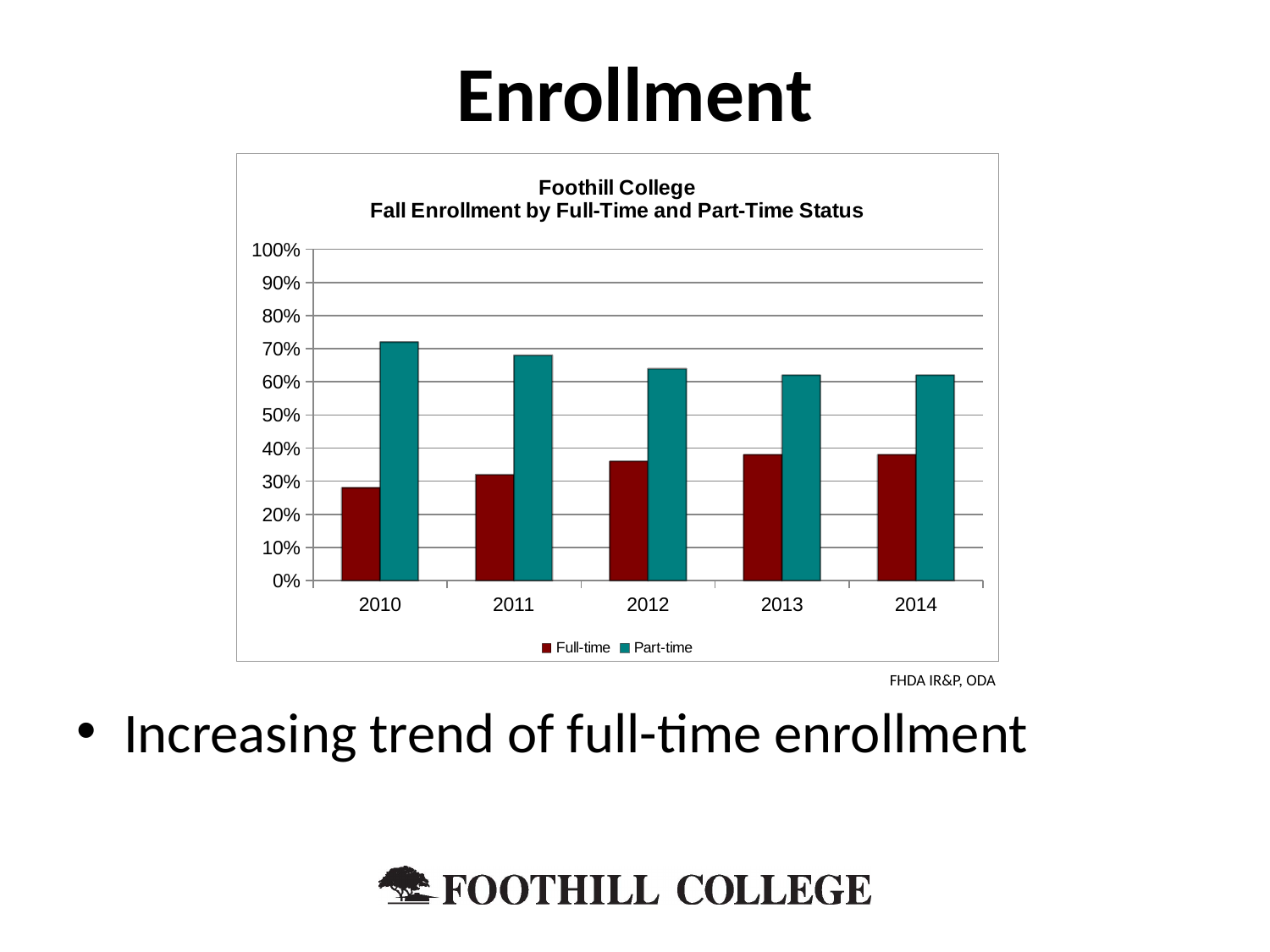
Which year has the lowest Full-time value? 2010 Is the Full-time value for 2010 greater or less than 30%? less Which year has the highest Part-time value? 2010 Which is larger, the Full-time value for 2010 or the Full-time value for 2012? 2012 What is the title of the chart? Foothill College Fall Enrollment by Full-Time and Part-Time Status Does the Part-time series rise or fall from 2010 to 2014? fall What kind of chart is shown on the slide? bar chart Is the Full-time value for 2014 greater or less than 40%? less How many years are shown on the x axis of the chart? 5 Is the Part-time value for 2010 greater or less than 70%? greater Does the Full-time series rise or fall from 2010 to 2014? rise How many series does the chart's legend list? 2